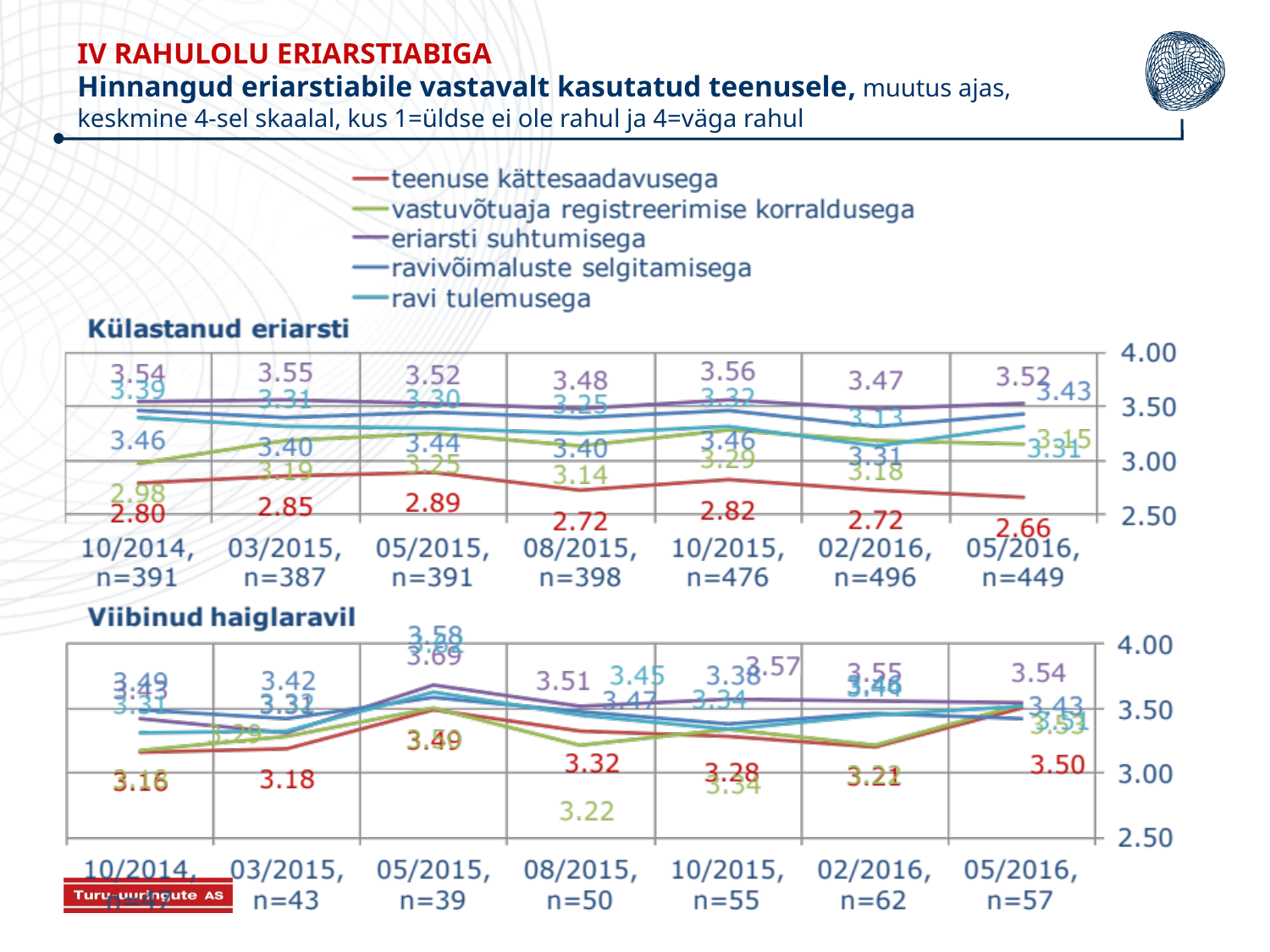
How many series does the legend list? 5 In the 'Külastanud eriarsti' chart, which is larger at 10/2014: 'eriarsti suhtumisega' or 'teenuse kättesaadavusega'? eriarsti suhtumisega In the 'Külastanud eriarsti' chart, what is the value for 'eriarsti suhtumisega' at 10/2015? 3.56 In the 'Viibinud haiglaravil' chart, what is the value for 'vastuvõtuaja registreerimise korraldusega' at 08/2015? 3.22 In the 'Külastanud eriarsti' chart, is the value for 'teenuse kättesaadavusega' at 03/2015 greater or less than 3.00? less In the 'Külastanud eriarsti' chart, what is the value for 'teenuse kättesaadavusega' at 05/2016? 2.66 In the 'Viibinud haiglaravil' chart, what is the value for 'eriarsti suhtumisega' at 05/2015? 3.69 In the 'Külastanud eriarsti' chart, at which time point is 'teenuse kättesaadavusega' lowest? 05/2016 What type of chart is used on this slide? line chart In the 'Külastanud eriarsti' chart, what is the difference between the 'teenuse kättesaadavusega' values at 05/2015 and 05/2016? 0.23 In the 'Külastanud eriarsti' chart, at which time point is 'teenuse kättesaadavusega' highest? 05/2015 In the 'Külastanud eriarsti' chart, how many time points are shown on the x axis? 7